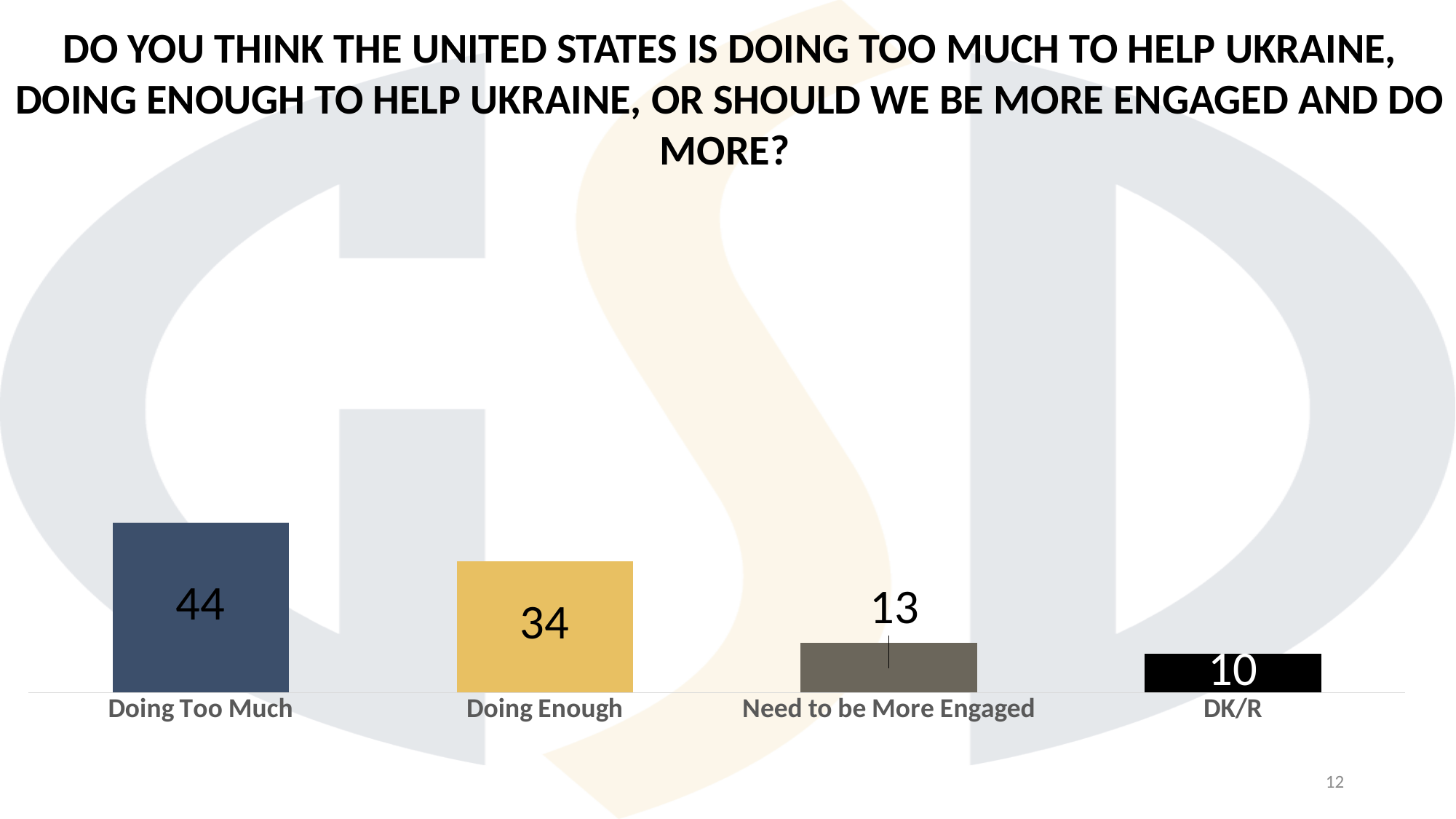
Which category has the highest value? Doing Too Much Which is larger, the value for Need to be More Engaged or the value for DK/R? Need to be More Engaged Do the values rise or fall from left to right across the categories? Fall What is the difference between the values for Doing Too Much and Doing Enough? 10 What is the difference between the values for Doing Enough and Need to be More Engaged? 21 What is the value for Need to be More Engaged? 13 What is the value for Doing Too Much? 44 What kind of chart is shown on the slide? Bar chart What is the value for Doing Enough? 34 How many categories are shown in the chart? 4 Which category has the lowest value? DK/R What is the value for DK/R? 10